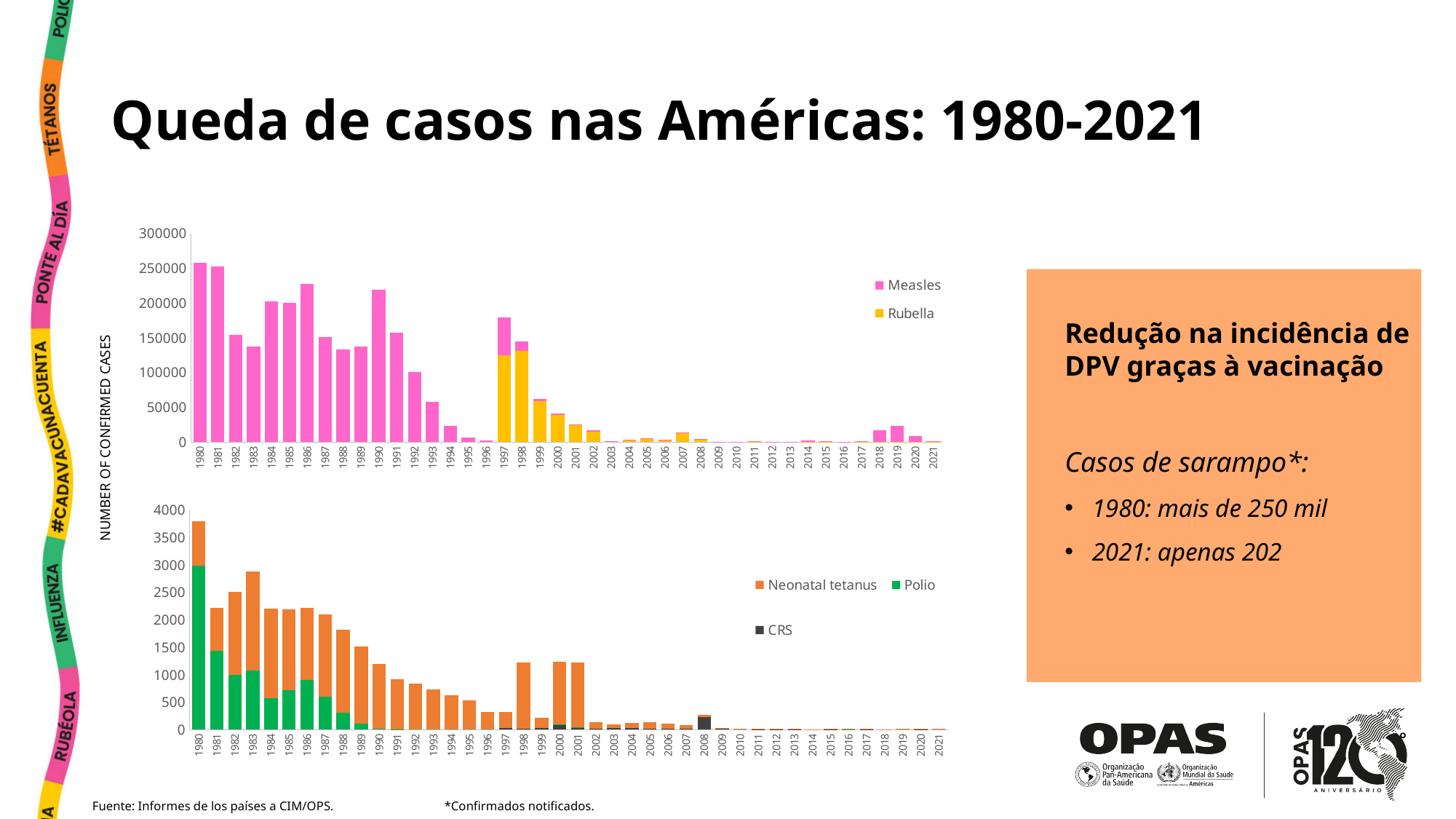
How many series does the legend of the top chart list? 2 In the bottom chart, which year has the highest Polio value? 1980 What type of chart is the top chart on the slide? Bar chart In the bottom chart, is the total for 1996 greater or less than 500? less In the bottom chart, which year has the highest total of the stacked bar? 1980 In the top chart, is the value for Measles in 1990 greater or less than 200000? greater In the top chart, is the value for Measles in 1993 greater or less than 100000? less In the bottom chart, what colour represents Neonatal tetanus? Orange How many series does the legend of the bottom chart list? 3 In the top chart, which is larger, the Measles value for 1990 or for 1992? 1990